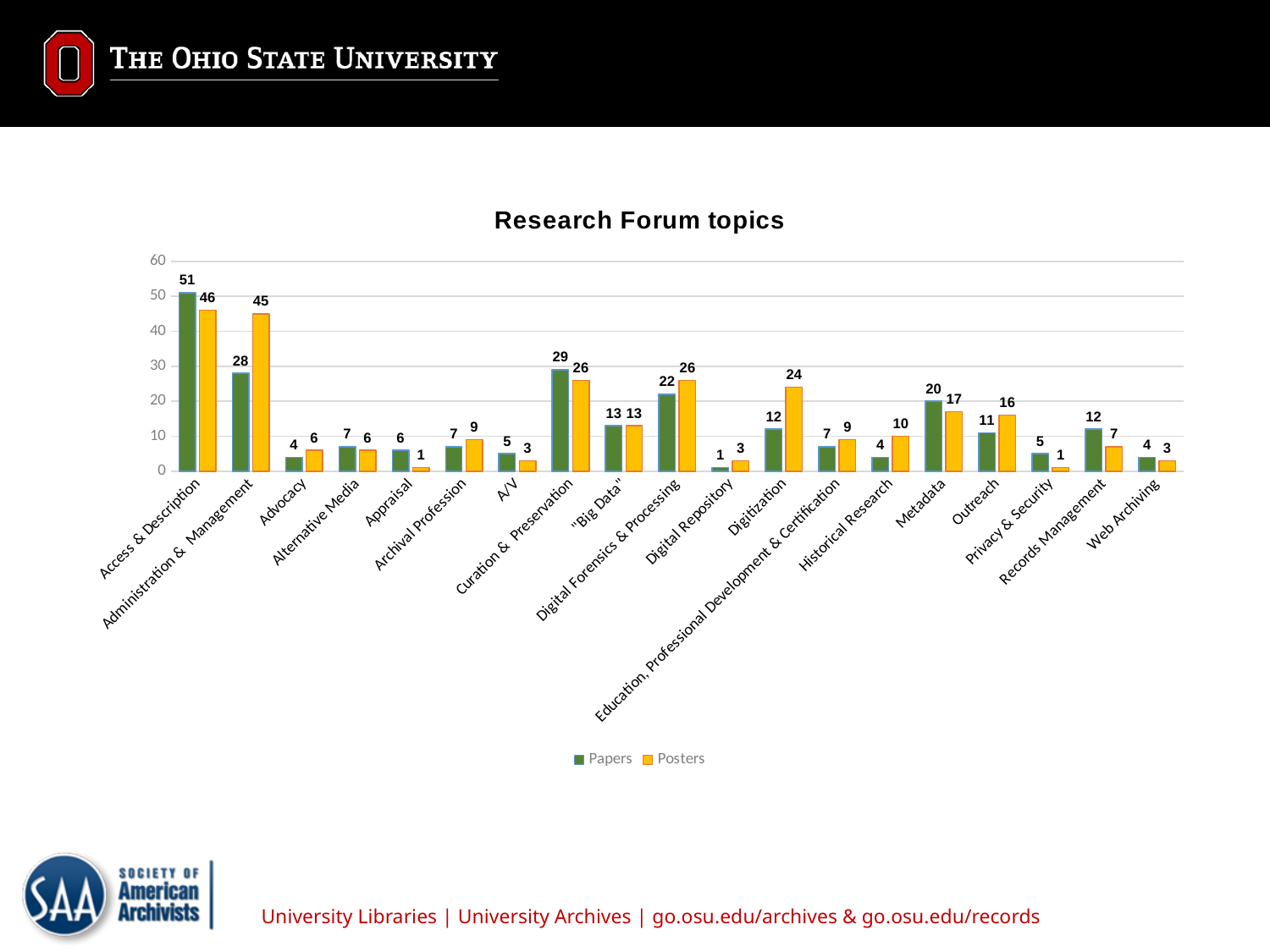
What kind of chart is shown on the slide? Bar chart How many categories are shown on the x axis? 19 What is the title of the chart? Research Forum topics What is the Papers value for Access & Description? 51 Which category has the lowest Papers value? Digital Repository Which is larger for Digital Forensics & Processing, Papers or Posters? Posters What is the difference between the Posters and Papers values for Administration & Management? 17 Is the Posters value for Access & Description greater or less than 40? greater How many series does the legend list? 2 Which category has the highest Papers value? Access & Description What is the Posters value for Digitization? 24 What is the Papers value for Metadata? 20